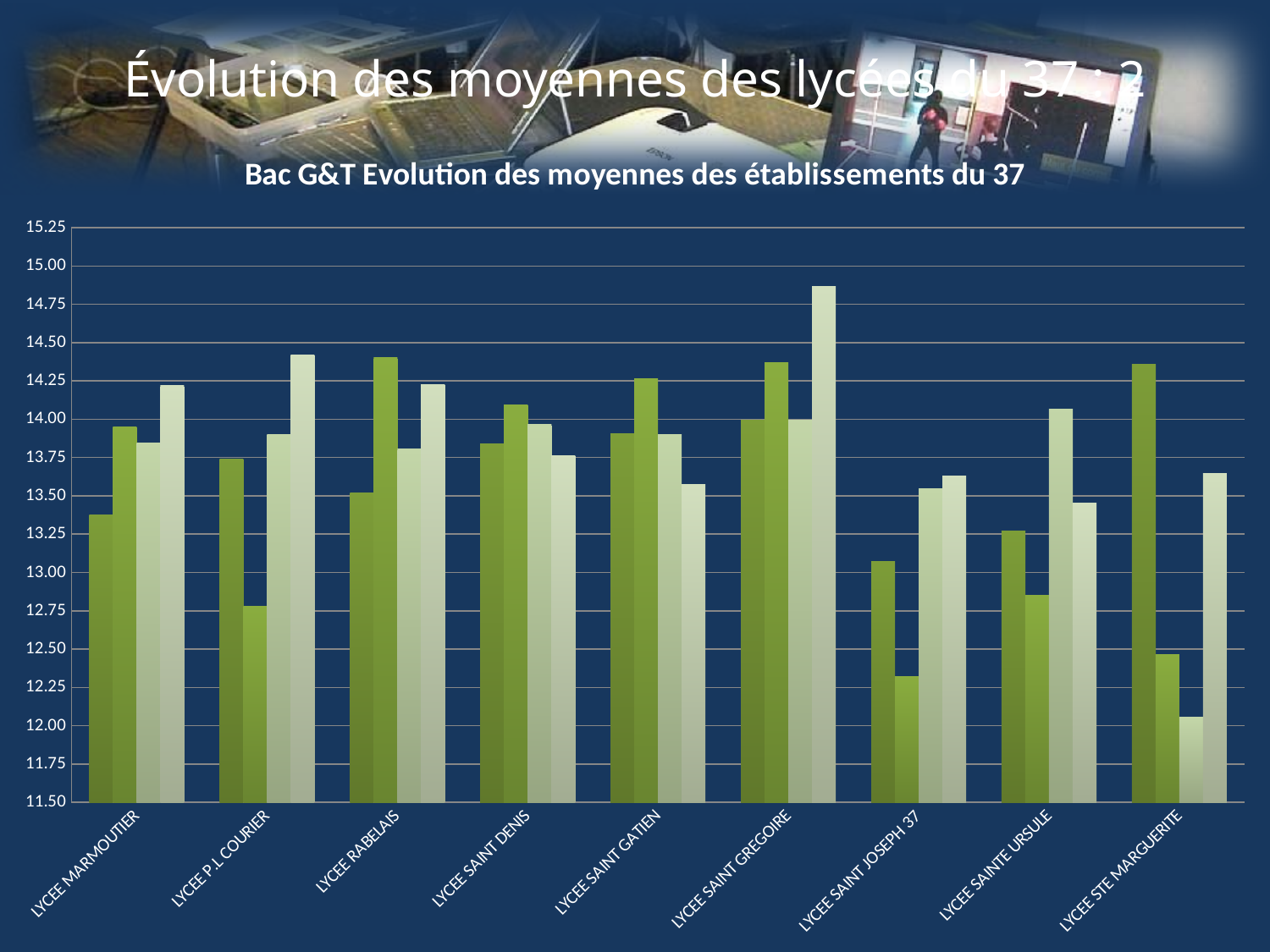
Which is larger for LYCEE STE MARGUERITE: the second bar or the third bar? the second bar Is the value of the fourth (rightmost) bar for LYCEE SAINT GREGOIRE greater or less than 14.75? greater Which is larger: the fourth bar for LYCEE SAINT GREGOIRE or the second bar for LYCEE RABELAIS? the fourth bar for LYCEE SAINT GREGOIRE Which lycée has the shortest bar in the chart? LYCEE STE MARGUERITE Is the value of the third bar for LYCEE STE MARGUERITE greater or less than 12.25? less Is the value of the second bar for LYCEE P.L COURIER greater or less than 13.00? less What kind of chart is shown on the slide? bar chart How many lycées (categories) are shown on the x axis of the chart? 9 What is the title of the chart? Bac G&T Evolution des moyennes des établissements du 37 Which lycée has the tallest bar in the chart? LYCEE SAINT GREGOIRE